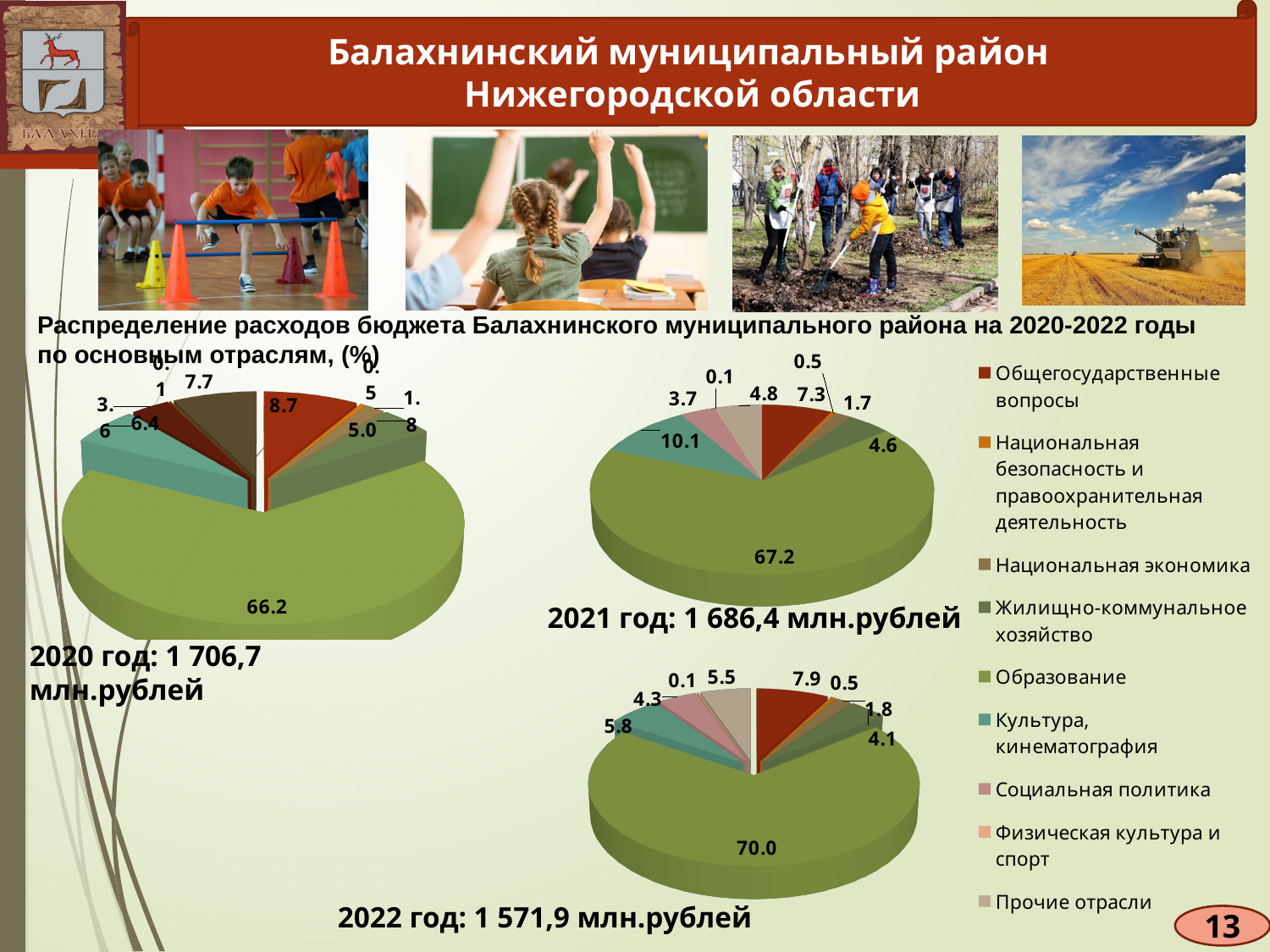
In the 2021 pie chart, what share does Образование have? 67.2 In the 2021 pie chart, which category has the largest share? Образование In the 2022 pie chart, what share does Образование have? 70.0 In the 2022 pie chart, which category has the smallest share? Физическая культура и спорт What is the difference between the Образование share in the 2022 chart and in the 2021 chart? 2.8 In the 2021 pie chart, what share does Культура, кинематография have? 10.1 In the 2022 pie chart, what share does Общегосударственные вопросы have? 7.9 How many categories does the legend list for the pie charts? 9 What type of chart is used to show the 2022 budget distribution? Pie chart In the 2021 pie chart, which is larger: Общегосударственные вопросы or Жилищно-коммунальное хозяйство? Общегосударственные вопросы What total budget amount is stated for the 2021 chart? 1 686,4 млн.рублей In the 2020 pie chart, what share does Образование have? 66.2